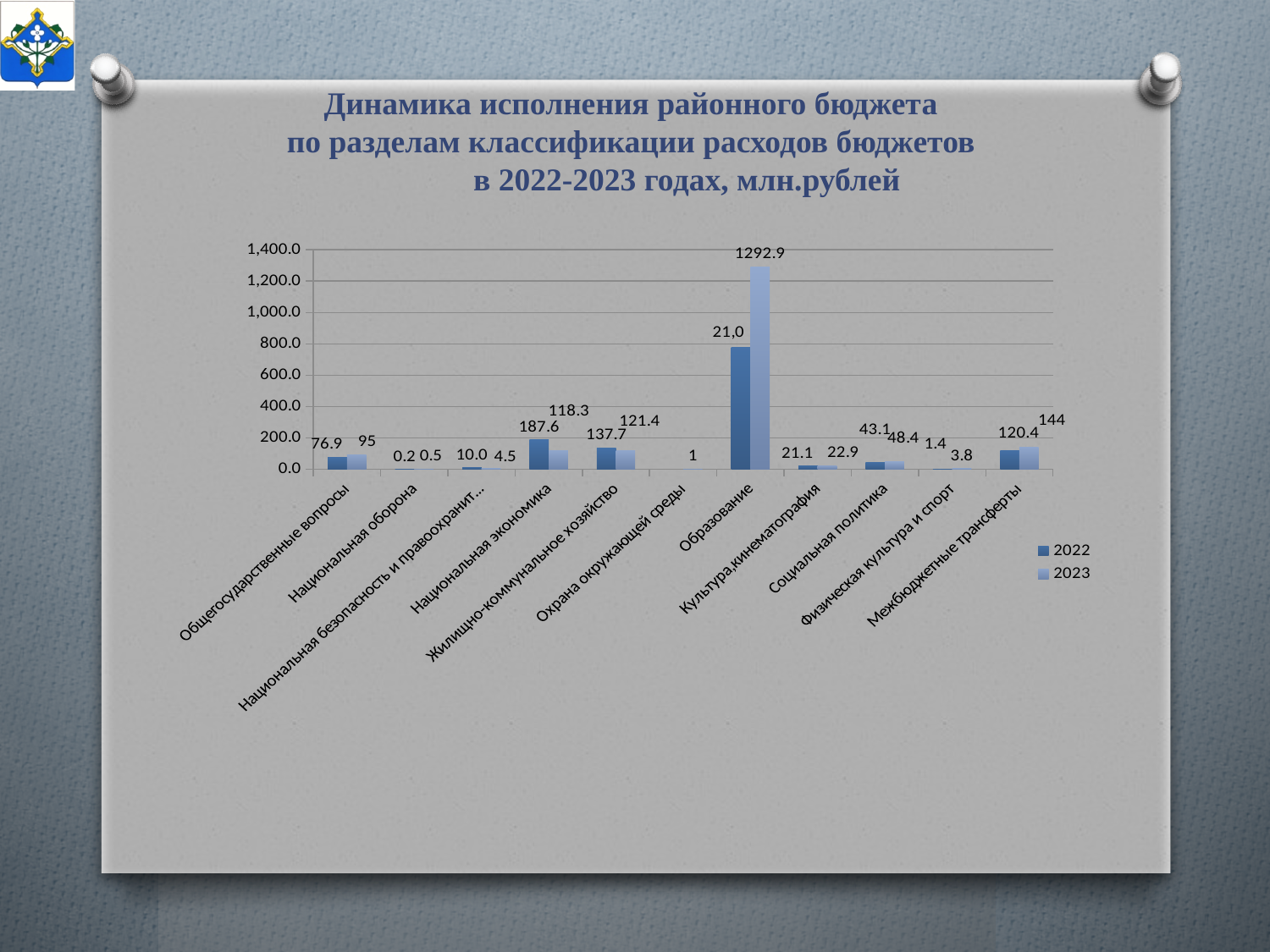
What kind of chart is shown on the slide? bar chart What is the 2022 value for Социальная политика? 43.1 How many series does the legend list? 2 Which category has the highest 2023 value? Образование What is the 2022 value for Национальная экономика? 187.6 What is the 2023 value for Межбюджетные трансферты? 144 What are the two entries in the legend? 2022 and 2023 Is the 2022 value for Образование greater or less than 600? greater What is the difference between the 2023 and 2022 values for Межбюджетные трансферты? 23.6 What is the 2023 value for Образование? 1292.9 How many categories are shown on the x axis? 11 For Национальная экономика, which year has the larger value, 2022 or 2023? 2022